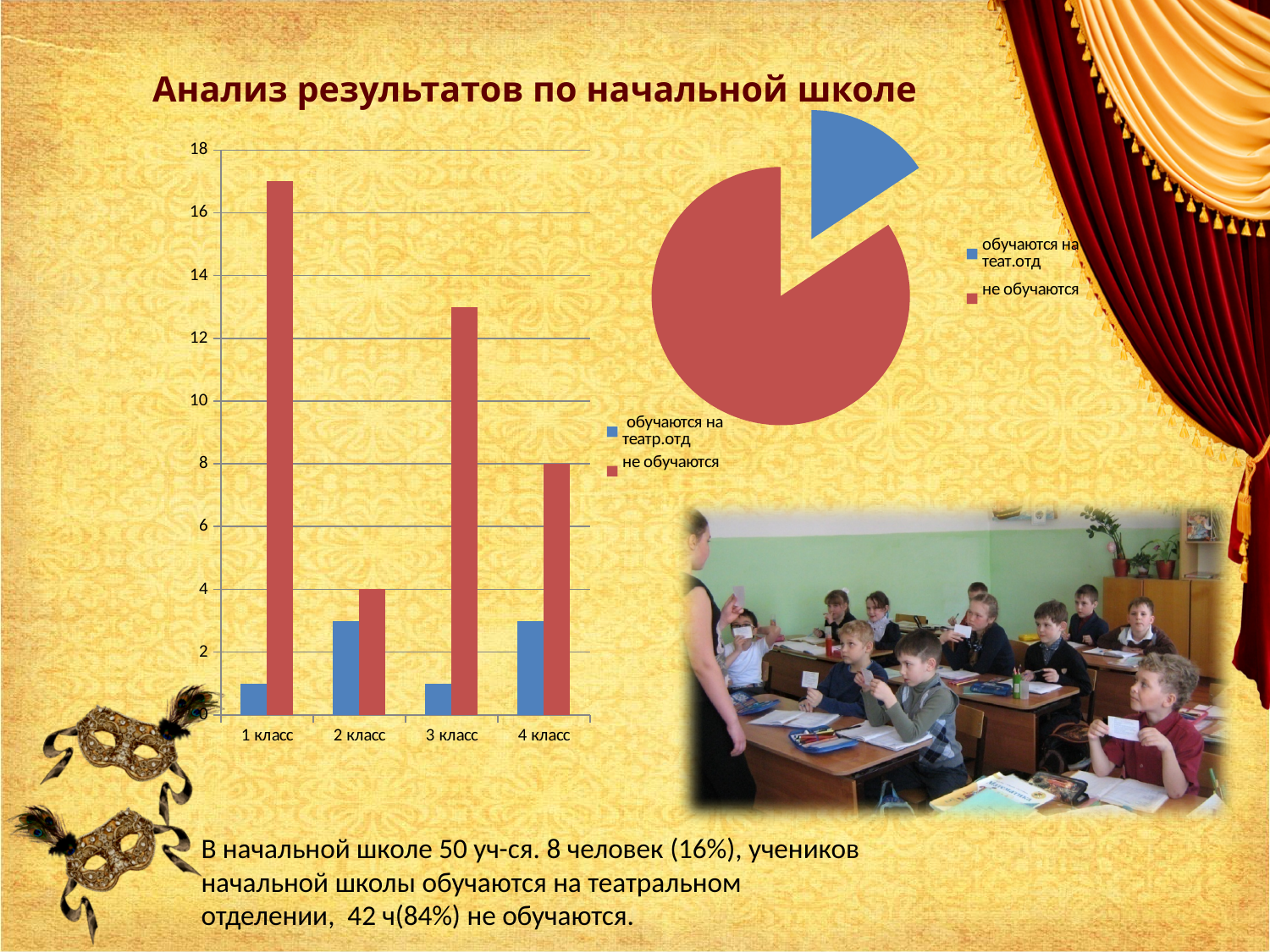
In the bar chart on the left, how many series does the legend list? 2 In the pie chart, which slice is larger: 'обучаются на теат.отд' or 'не обучаются'? не обучаются In the bar chart on the left, what is the value of 'не обучаются' for 2 класс? 4 What type of chart is the chart in the upper right of the slide? pie chart What type of chart is the chart on the left of the slide? bar chart In the bar chart on the left, is the value of 'не обучаются' for 1 класс greater or less than 16? greater In the bar chart on the left, which class has the lowest value for 'не обучаются'? 2 класс In the bar chart on the left, what is the value of 'не обучаются' for 4 класс? 8 In the bar chart on the left, which is larger for 3 класс: 'обучаются на театр.отд' or 'не обучаются'? не обучаются In the bar chart on the left, which class has the highest value for 'не обучаются'? 1 класс In the bar chart on the left, how many classes are shown on the x axis? 4 In the bar chart on the left, is the value of 'не обучаются' for 3 класс greater or less than 12? greater